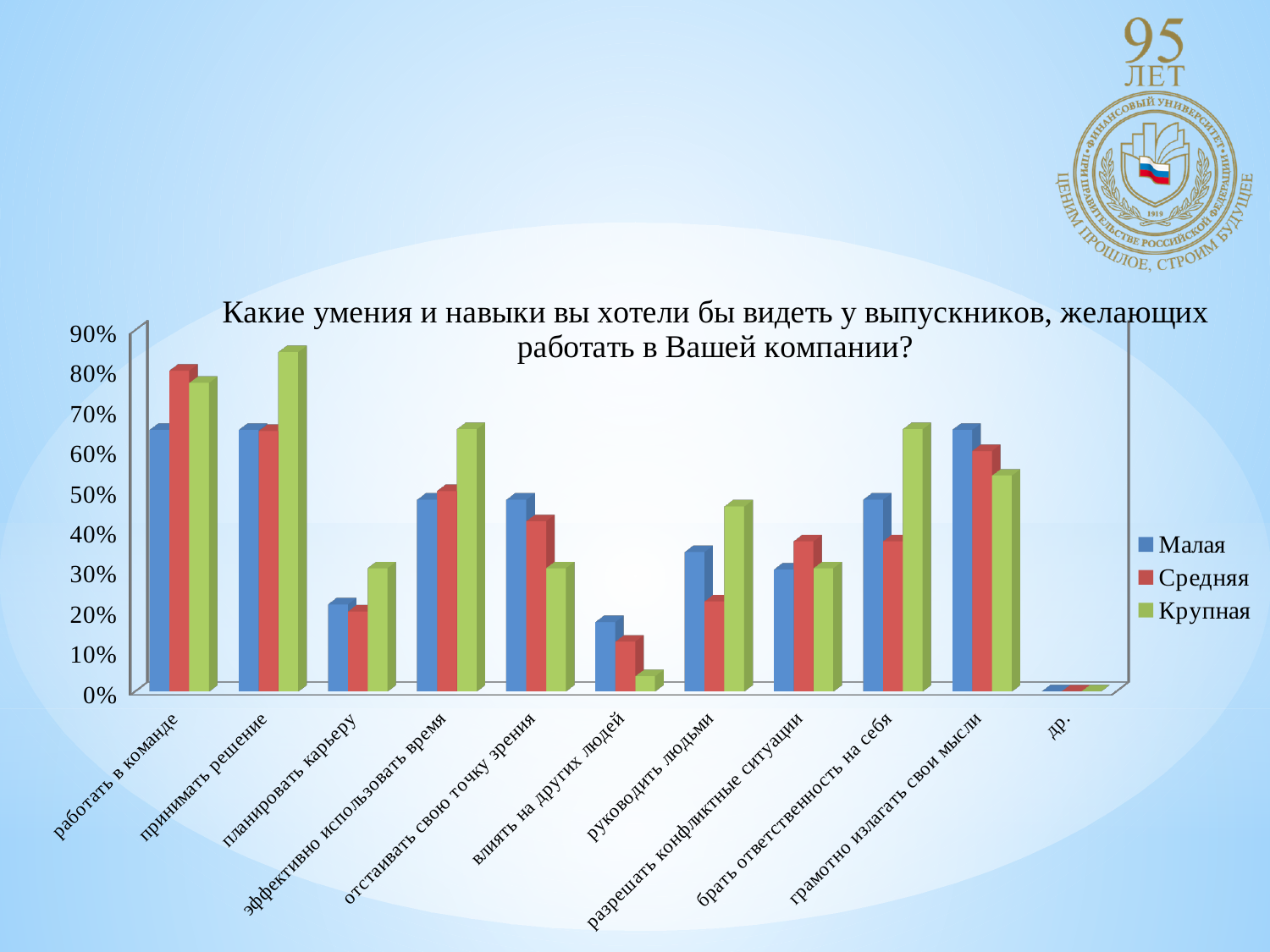
Which category has the highest value for the Крупная series? принимать решение Is the Крупная value for 'влиять на других людей' greater or less than 10%? less What are the three entries in the chart legend? Малая, Средняя, Крупная How many series does the legend list? 3 For 'брать ответственность на себя', which series has the larger value: Крупная or Малая? Крупная What kind of chart is shown on the slide? bar chart Which category has the highest value for the Средняя series? работать в команде For 'руководить людьми', which series has the larger value: Малая or Средняя? Малая Is the Средняя value for 'планировать карьеру' greater or less than 30%? less How many categories are shown along the x axis? 11 Which colour represents the Крупная series? green Is the Малая value for 'работать в команде' greater or less than 60%? greater